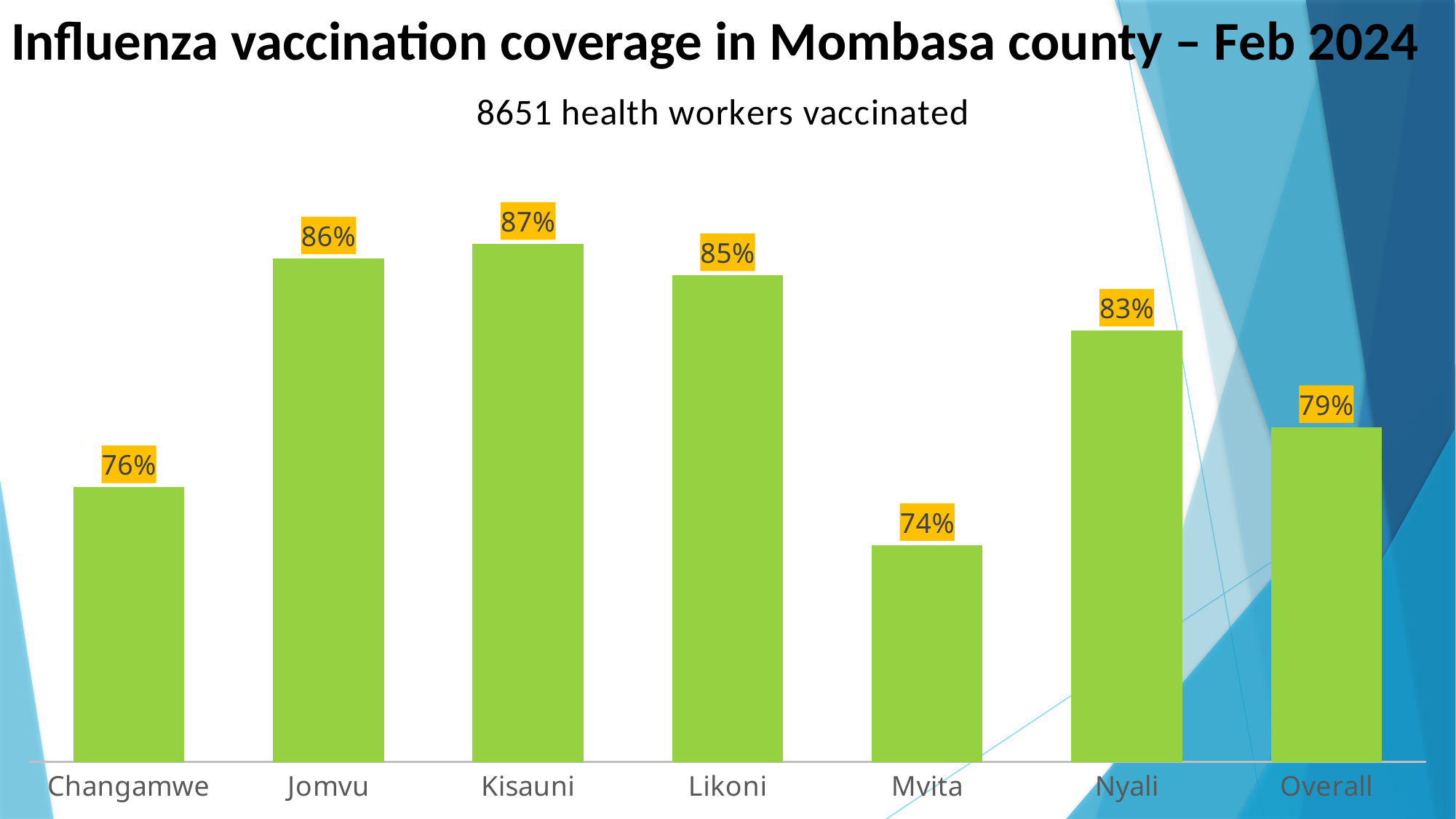
What is the vaccination coverage for Kisauni? 87% Which sub-county has the lowest vaccination coverage? Mvita What is the chart's subtitle below the main title? 8651 health workers vaccinated Which has higher coverage, Likoni or Nyali? Likoni What is the vaccination coverage for Mvita? 74% What is the difference in coverage between Jomvu and Changamwe? 10% What is the vaccination coverage for Nyali? 83% What colour are the bars on the chart? Green How many bars are shown on the chart? 7 What is the Overall vaccination coverage shown on the chart? 79% What type of chart is shown on the slide? Bar chart Which sub-county has the highest vaccination coverage? Kisauni